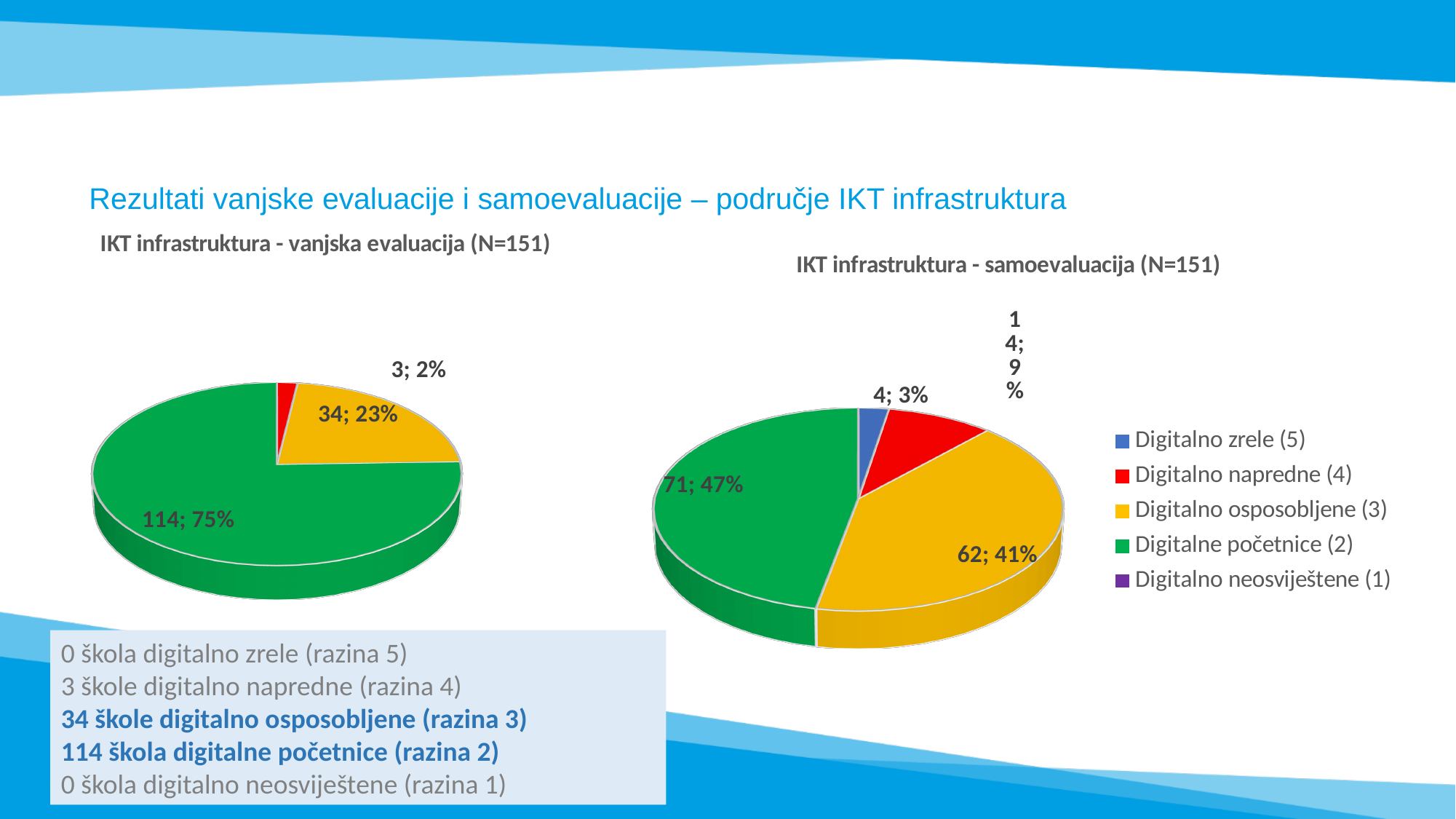
What type of chart is used for 'IKT infrastruktura - vanjska evaluacija (N=151)'? Pie chart In the 'IKT infrastruktura - samoevaluacija (N=151)' chart, which category has the smallest slice? Digitalno zrele (5) Which chart has the larger count for Digitalno napredne (4): 'vanjska evaluacija' or 'samoevaluacija'? samoevaluacija What colour represents Digitalno osposobljene (3) in the legend? Yellow In the 'IKT infrastruktura - vanjska evaluacija (N=151)' chart, what is the value for Digitalno osposobljene (3)? 34; 23% In the 'IKT infrastruktura - samoevaluacija (N=151)' chart, what is the value for Digitalno osposobljene (3)? 62; 41% In the 'IKT infrastruktura - vanjska evaluacija (N=151)' chart, what share of the pie is Digitalno napredne (4)? 2% In the 'IKT infrastruktura - vanjska evaluacija (N=151)' chart, what is the value for Digitalne početnice (2)? 114; 75% In the 'IKT infrastruktura - samoevaluacija (N=151)' chart, what is the value for Digitalno zrele (5)? 4; 3% How many entries does the legend list? 5 In the 'IKT infrastruktura - vanjska evaluacija (N=151)' chart, which category has the largest slice? Digitalne početnice (2) In the 'IKT infrastruktura - samoevaluacija (N=151)' chart, what is the difference between the counts for Digitalne početnice (2) and Digitalno osposobljene (3)? 9